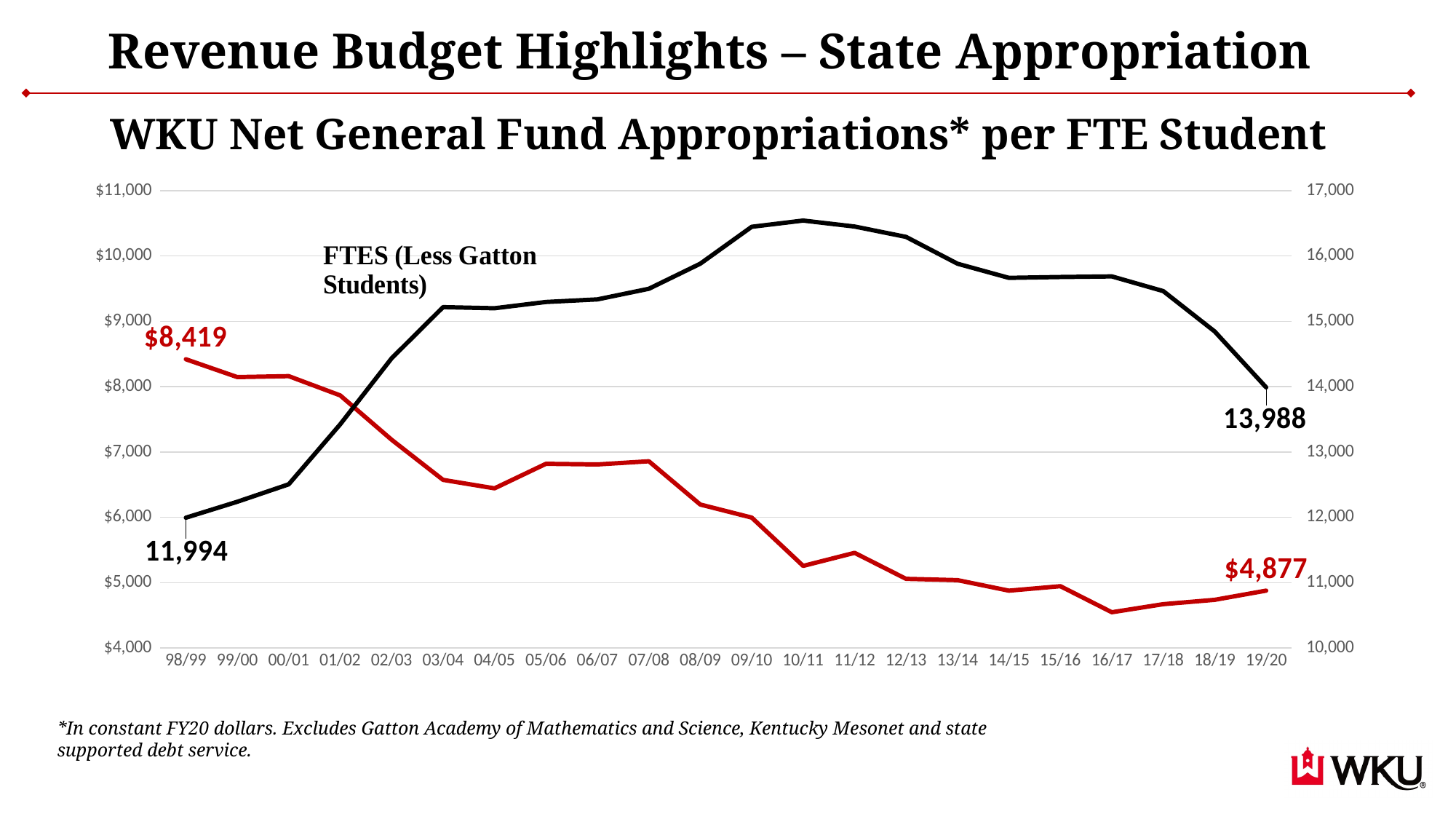
What kind of chart is shown on the slide? Line chart Is the FTES (Less Gatton Students) value in 10/11 greater or less than 16,000? greater Which is larger, the appropriation per FTE student in 98/99 or in 19/20? 98/99 Is the appropriation per FTE student in 16/17 greater or less than $5,000? less By how much did the appropriation per FTE student fall from 98/99 to 19/20? $3,542 How many fiscal years are plotted along the x axis? 22 What is the FTES (Less Gatton Students) value in 98/99? 11,994 By how much did FTES (Less Gatton Students) increase from 98/99 to 19/20? 1,994 Does the appropriation per FTE student line generally rise or fall from 98/99 to 19/20? Fall What is the net general fund appropriation per FTE student in 98/99? $8,419 What is the net general fund appropriation per FTE student in 19/20? $4,877 What is the FTES (Less Gatton Students) value in 19/20? 13,988